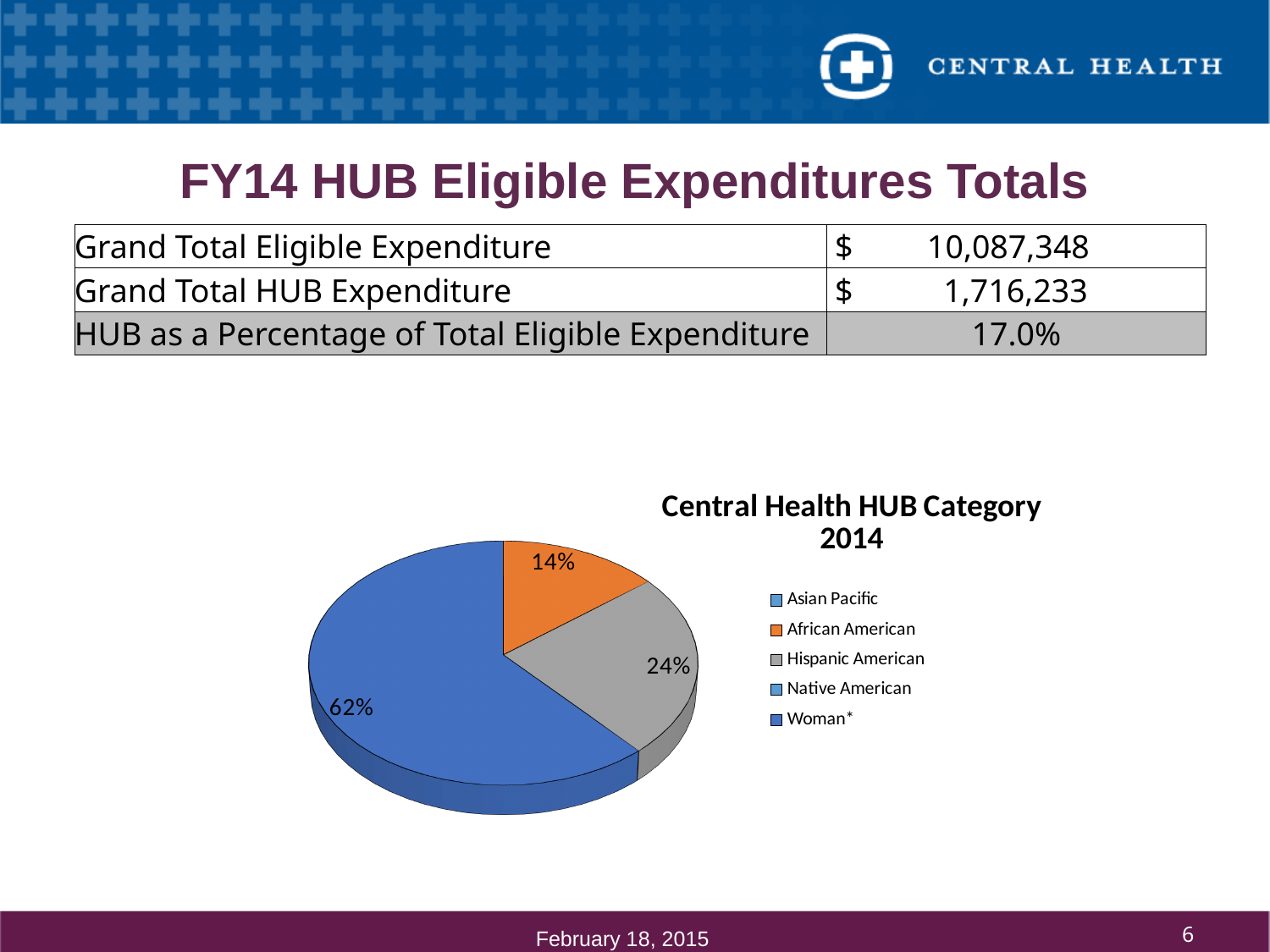
What is the largest percentage printed on the pie chart? 62% What kind of chart is shown on the slide? pie chart Is the largest slice of the pie chart greater or less than 50%? greater What percentage is shown for the Hispanic American slice of the pie chart? 24% What is the title of the pie chart? Central Health HUB Category 2014 What percentage is shown for the African American slice of the pie chart? 14% What is the smallest percentage printed on the pie chart? 14% What colour is the African American slice in the pie chart? orange What do the three percentages printed on the pie chart add up to? 100% Which slice is larger, African American or Hispanic American? Hispanic American How many percentage points larger is the Hispanic American slice than the African American slice? 10 percentage points How many categories does the pie chart's legend list? 5